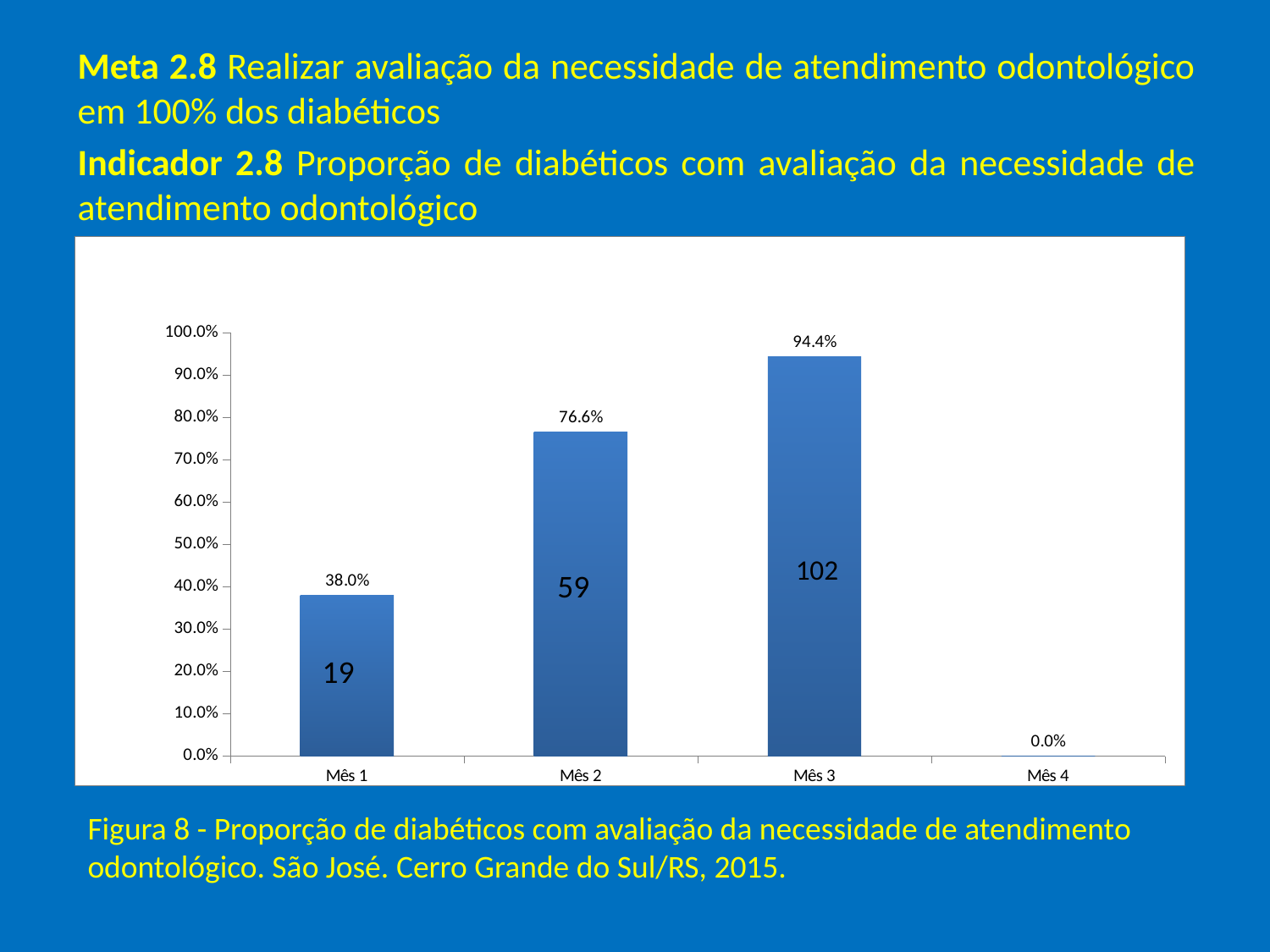
Which month has the lowest value? Mês 4 Which month has the highest value? Mês 3 What is the value for Mês 2? 76.6% What is the value for Mês 3? 94.4% What kind of chart is shown on the slide? Bar chart What is the difference between the values for Mês 3 and Mês 2? 17.8% Do the values rise or fall from Mês 1 to Mês 3? Rise Which is larger, the value for Mês 1 or the value for Mês 2? Mês 2 What number is printed inside the bar for Mês 2? 59 What is the value for Mês 1? 38.0% What is the value for Mês 4? 0.0% How many months are shown on the x axis? 4